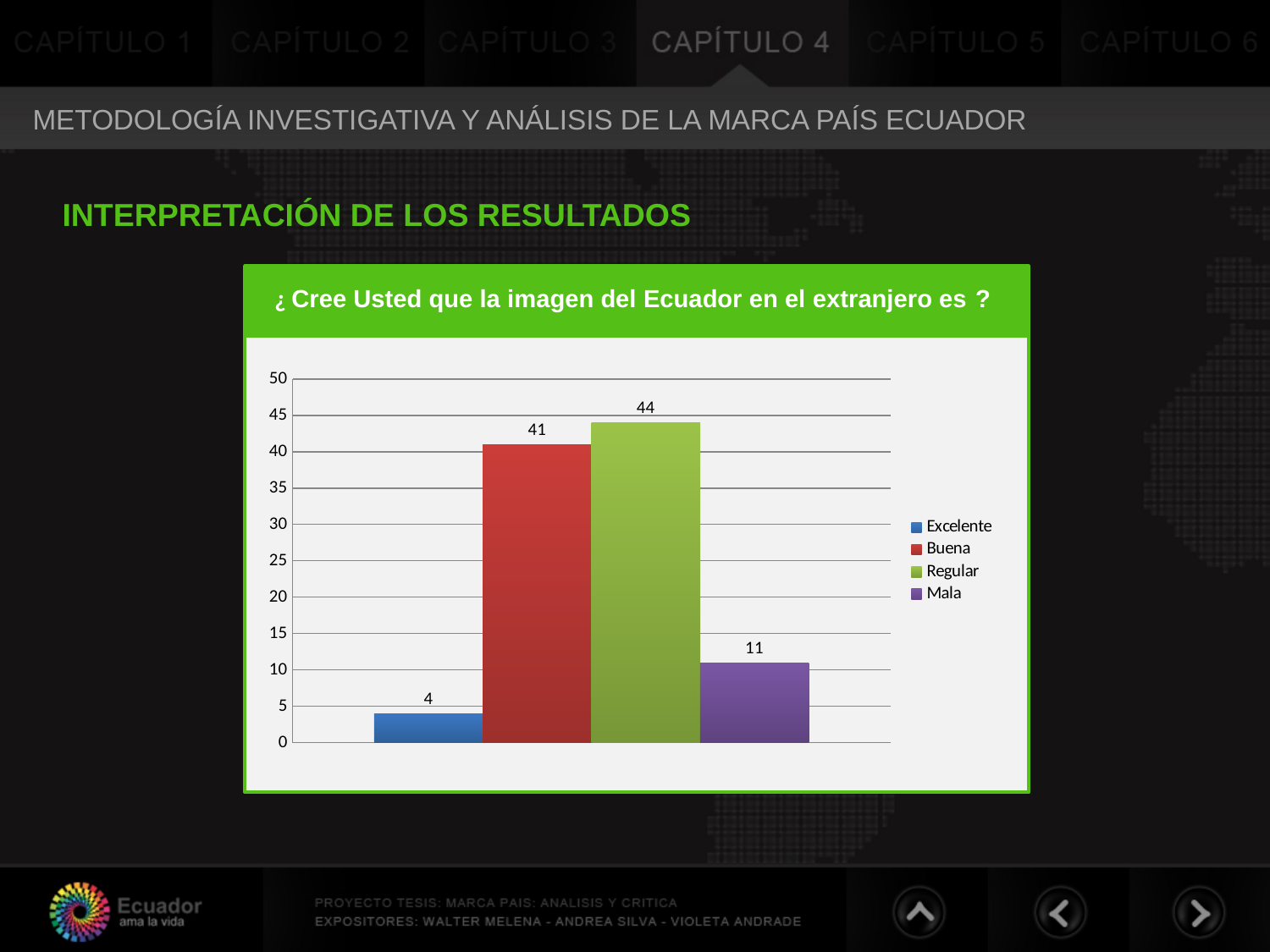
What is the value for Regular? 44 Which is larger, the value for Buena or the value for Mala? Buena What is the value for Mala? 11 What is the value for Excelente? 4 What is the difference between the values for Regular and Buena? 3 What kind of chart is shown on the slide? bar chart Which category has the lowest value? Excelente How many series does the legend list? 4 Is the value for Buena greater or less than 35? greater What is the title of the chart? ¿ Cree Usted que la imagen del Ecuador en el extranjero es ? What is the difference between the values for Mala and Excelente? 7 Which category has the highest value? Regular